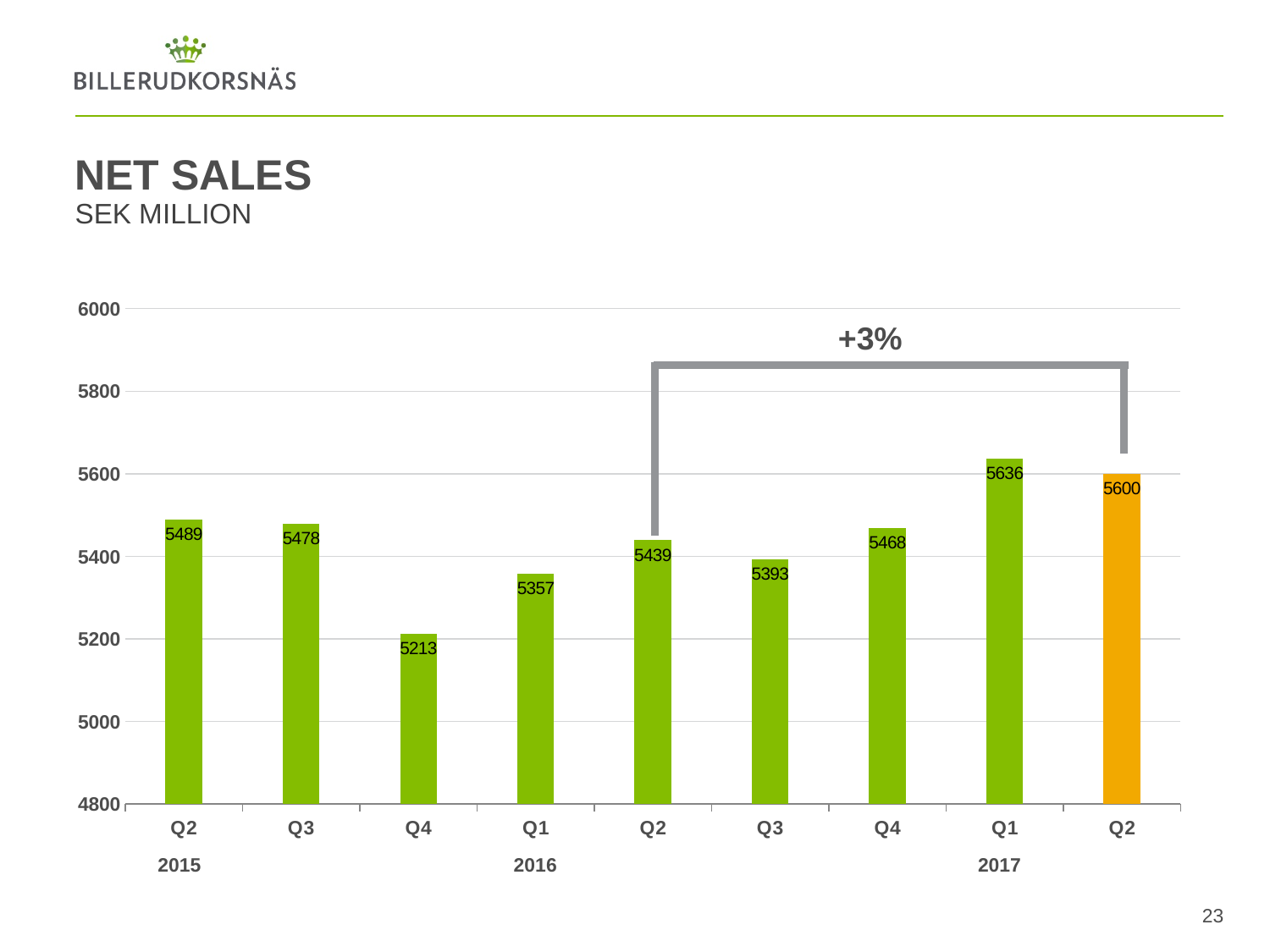
What is the difference in net sales between Q2 2016 and Q2 2017? 161 Which is larger, net sales in Q2 2015 or Q2 2016? Q2 2015 What is the difference in net sales between Q1 2017 and Q2 2017? 36 What is the net sales value for Q3 2016? 5393 What kind of chart is shown on the slide? Bar chart What percentage change is annotated between Q2 2016 and Q2 2017? +3% What is the net sales value for Q2 2017? 5600 Which quarter has the lowest net sales? Q4 2015 Which quarter has the highest net sales? Q1 2017 What is the net sales value for Q4 2015? 5213 How many quarters are shown on the chart? 9 Is the value for Q1 2016 greater or less than 5400? less